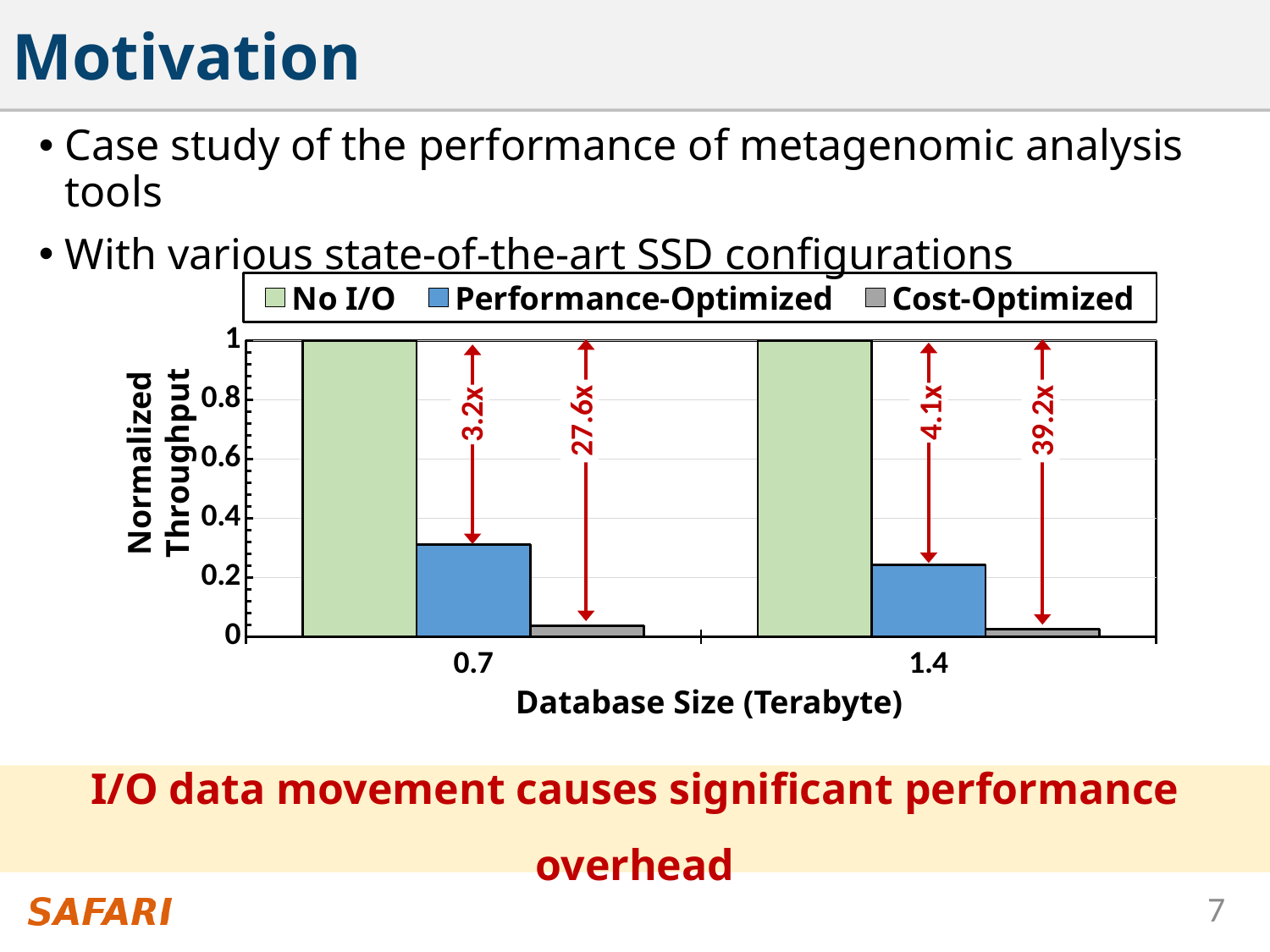
How many series does the legend list? 3 What slowdown factor is annotated for the Cost-Optimized configuration at a database size of 0.7 terabytes? 27.6x How many database size categories are shown on the x axis? 2 What is the label of the x axis? Database Size (Terabyte) Is the normalized throughput of the Performance-Optimized configuration at 0.7 terabytes greater or less than 0.4? less What kind of chart is shown on the slide? bar chart What slowdown factor is annotated for the Cost-Optimized configuration at a database size of 1.4 terabytes? 39.2x Is the Performance-Optimized normalized throughput larger at 0.7 terabytes or at 1.4 terabytes? 0.7 What is the normalized throughput of the No I/O configuration at a database size of 0.7 terabytes? 1 Which configuration has the highest normalized throughput at a database size of 0.7 terabytes? No I/O Which configuration has the lowest normalized throughput at a database size of 1.4 terabytes? Cost-Optimized What slowdown factor is annotated for the Performance-Optimized configuration at a database size of 0.7 terabytes? 3.2x